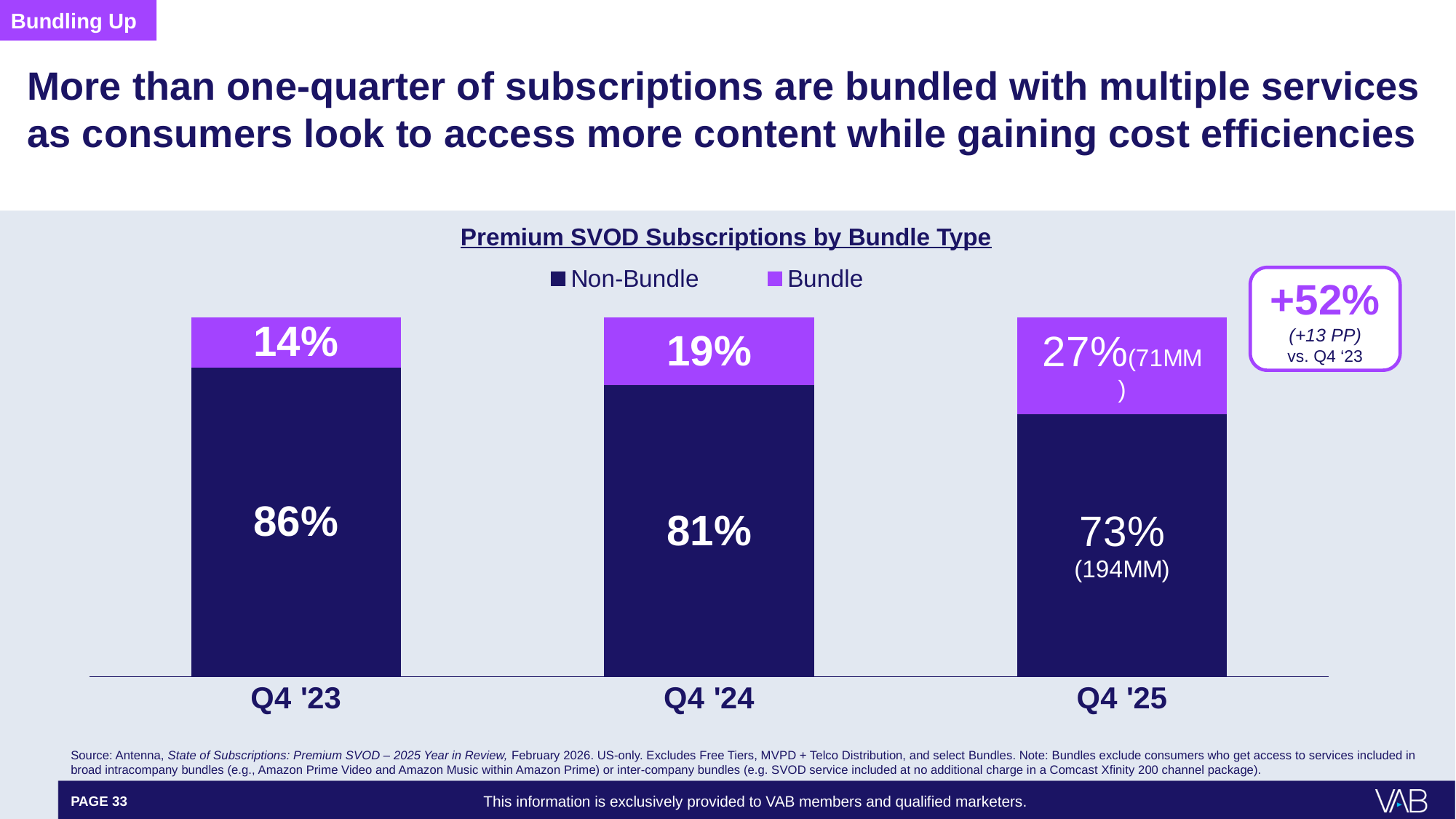
What is the Non-Bundle share of Premium SVOD subscriptions in Q4 '24? 81% What is the Bundle share of Premium SVOD subscriptions in Q4 '25? 27% How many series does the chart legend list? 2 By how many percentage points did the Bundle share increase from Q4 '23 to Q4 '25? 13 In which quarter is the Non-Bundle share lowest? Q4 '25 What is the Non-Bundle share of Premium SVOD subscriptions in Q4 '25? 73% What is the Bundle share of Premium SVOD subscriptions in Q4 '23? 14% What kind of chart is shown on the slide? Stacked bar chart In which quarter is the Bundle share highest? Q4 '25 How many quarters are shown on the x axis of the chart? 3 Does the Bundle share rise or fall from Q4 '23 to Q4 '25? Rise Which is larger in Q4 '24, the Bundle share or the Non-Bundle share? Non-Bundle